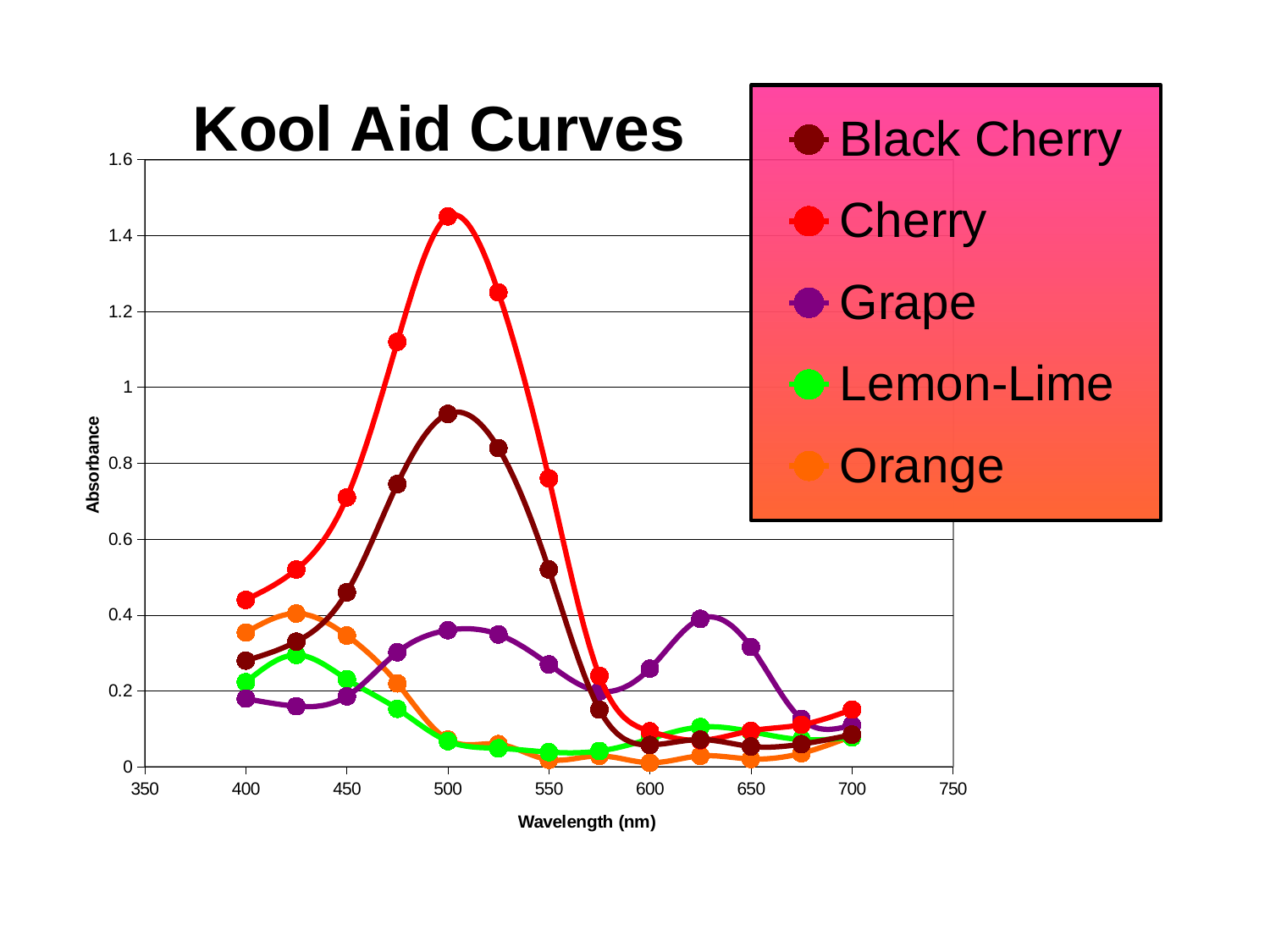
At 500 nm, which has the larger absorbance, Cherry or Black Cherry? Cherry Does the Cherry absorbance rise or fall between 500 nm and 600 nm? fall Is the absorbance for Cherry at 500 nm greater or less than 1.4? greater At 625 nm, which has the larger absorbance, Grape or Lemon-Lime? Grape What is the title of the chart? Kool Aid Curves What kind of chart is shown on the slide? line chart How many data points are plotted for the Cherry series? 13 Which series reaches the highest absorbance on the chart? Cherry Is the absorbance for Black Cherry at 500 nm greater or less than 1? less Is the absorbance for Grape at 625 nm greater or less than 0.2? greater What is the label on the x axis of the chart? Wavelength (nm) How many series does the legend list? 5